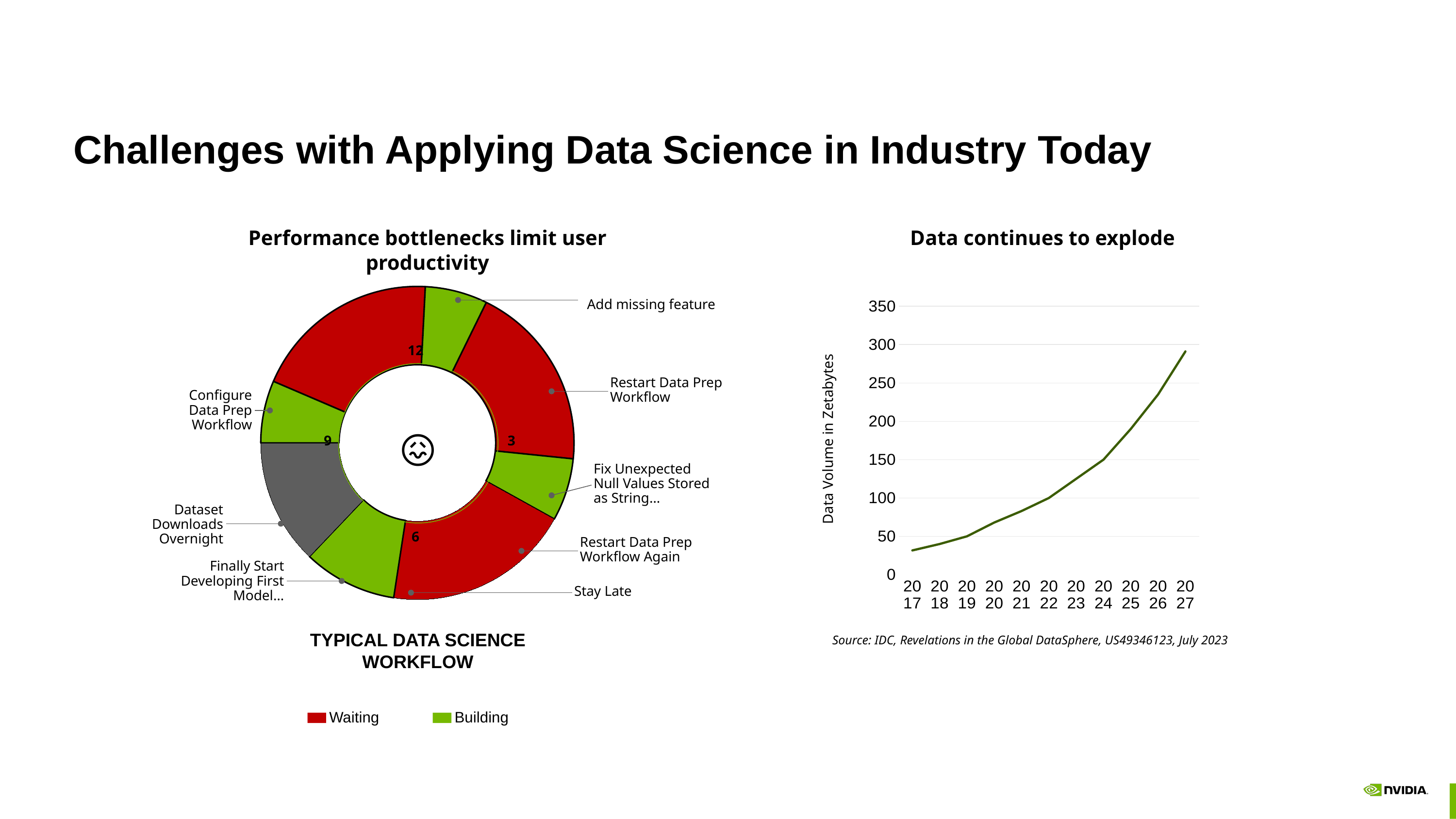
What is the y-axis label of the 'Data continues to explode' chart? Data Volume in Zetabytes In the 'Data continues to explode' chart, do the values rise or fall from 2017 to 2027? rise In the 'Data continues to explode' chart, is the value for 2017 greater or less than 50? less How many years are shown on the x axis of the 'Data continues to explode' chart? 11 In the 'Data continues to explode' chart, which year has the larger data volume, 2020 or 2025? 2025 What type of chart is the 'Data continues to explode' chart? line chart In the 'Data continues to explode' chart, which year has the highest data volume? 2027 In the 'Data continues to explode' chart, is the value for 2023 greater or less than 100? greater In the 'Data continues to explode' chart, is the value for 2021 greater or less than 100? less How many entries does the legend of the 'Performance bottlenecks limit user productivity' chart list? 2 In the 'Data continues to explode' chart, which year has the lowest data volume? 2017